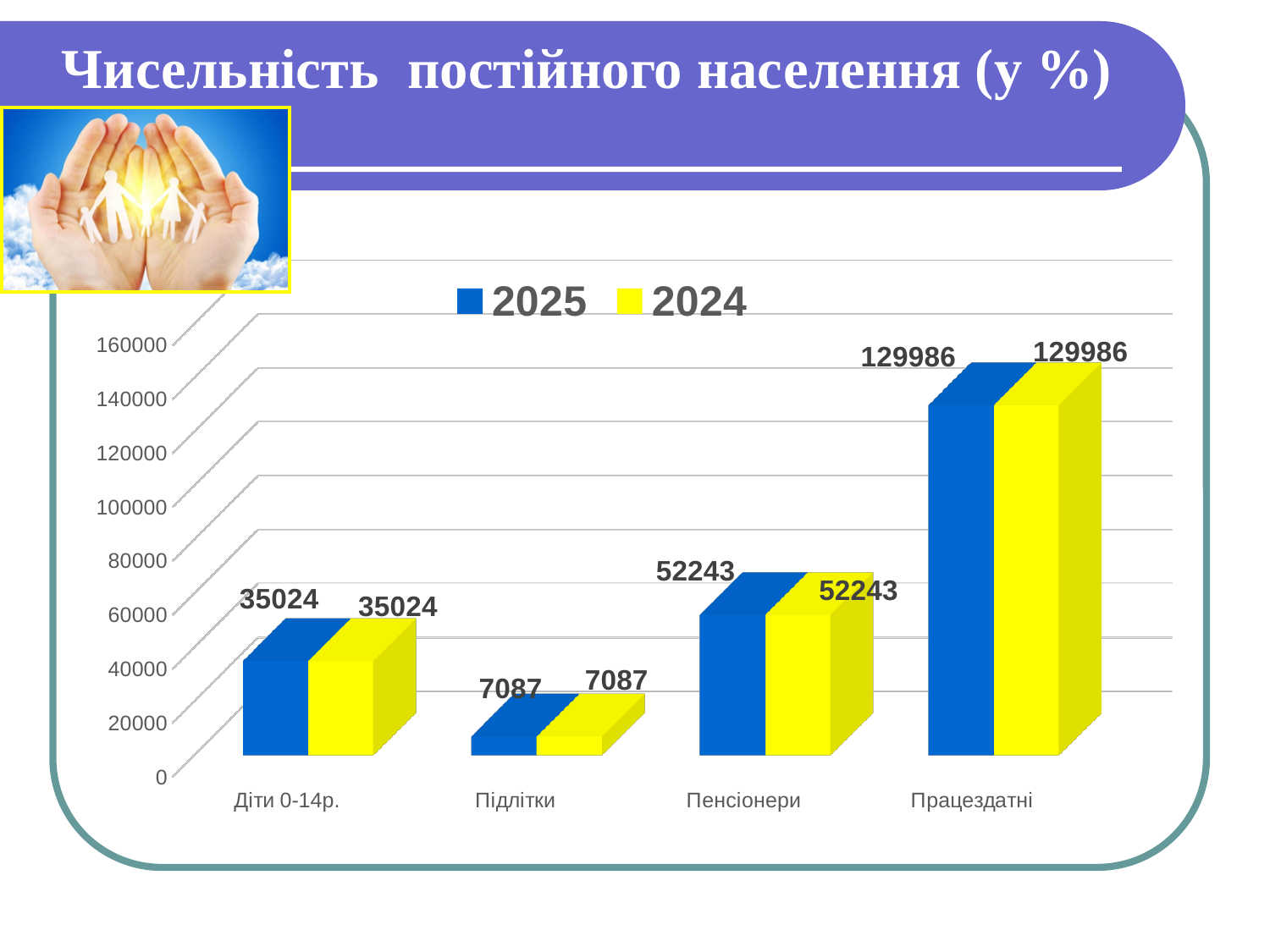
What is the value for Пенсіонери in the 2025 series? 52243 Which is larger in the 2024 series: Пенсіонери or Діти 0-14р.? Пенсіонери What is the value for Підлітки in the 2024 series? 7087 What is the difference between the 2025 values for Пенсіонери and Діти 0-14р.? 17219 How many series does the legend list? 2 Which category has the highest value in the 2025 series? Працездатні What is the value for Діти 0-14р. in the 2024 series? 35024 How many categories are shown on the x axis? 4 What is the value for Працездатні in the 2025 series? 129986 Which category has the lowest value in the 2024 series? Підлітки What kind of chart is shown on the slide? Bar chart Which colour represents the 2024 series in the legend? Yellow